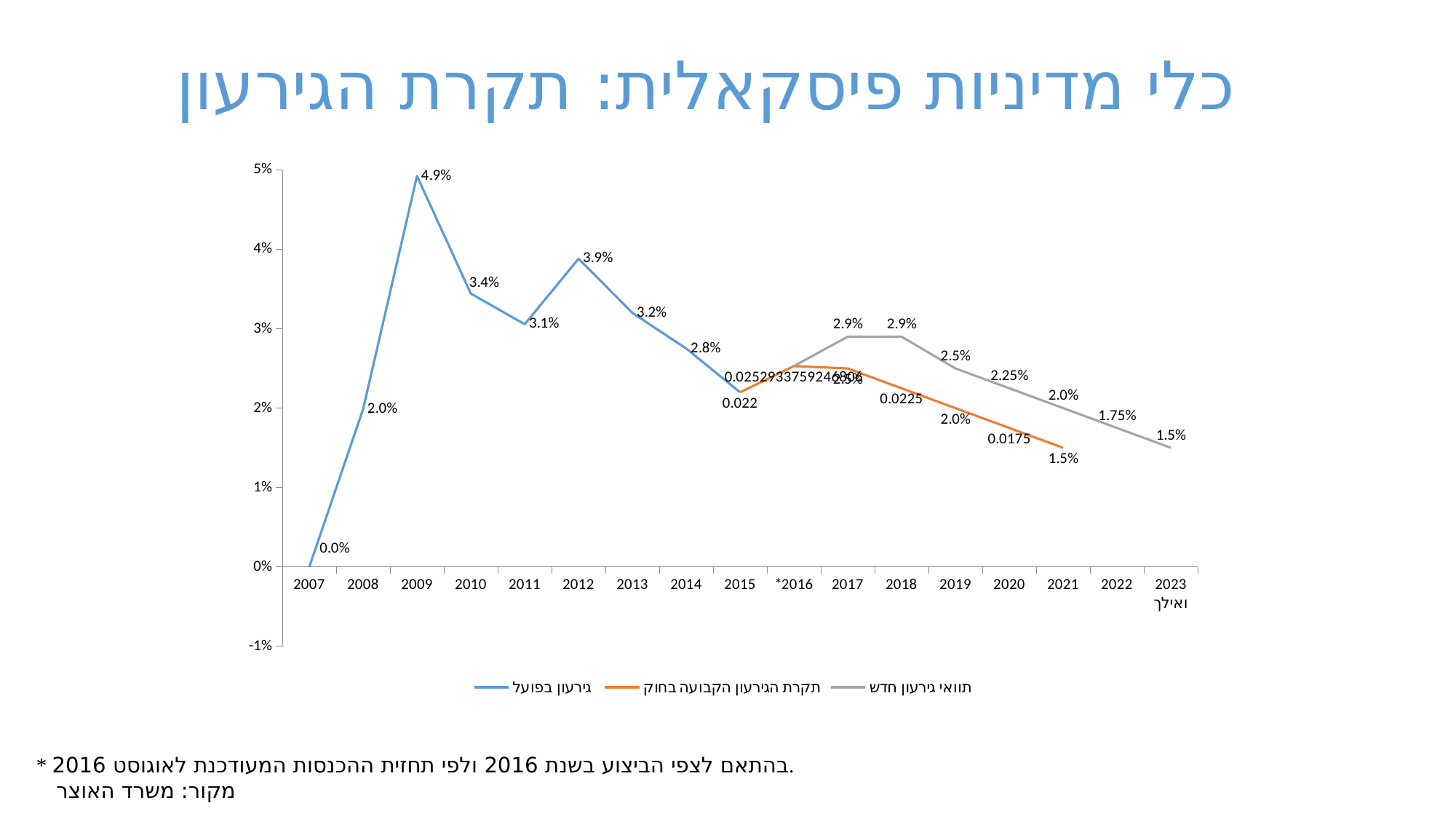
What is the value of the גירעון בפועל series in 2009? 4.9% Which is larger in 2019: the תוואי גירעון חדש value or the תקרת הגירעון הקבועה בחוק value? תוואי גירעון חדש Does the תוואי גירעון חדש series rise or fall from 2018 to 2023 ואילך? fall What type of chart is shown on the slide? line chart What is the value of the גירעון בפועל series in 2012? 3.9% In which year does the גירעון בפועל series reach its highest value? 2009 What is the value of the תוואי גירעון חדש series in 2020? 2.25% In which year does the גירעון בפועל series have its lowest value? 2007 How many series does the legend list? 3 What is the value of the תוואי גירעון חדש series in 2017? 2.9% What is the difference between the גירעון בפועל values in 2009 and 2010? 1.5% What is the value of the תקרת הגירעון הקבועה בחוק series in 2021? 1.5%